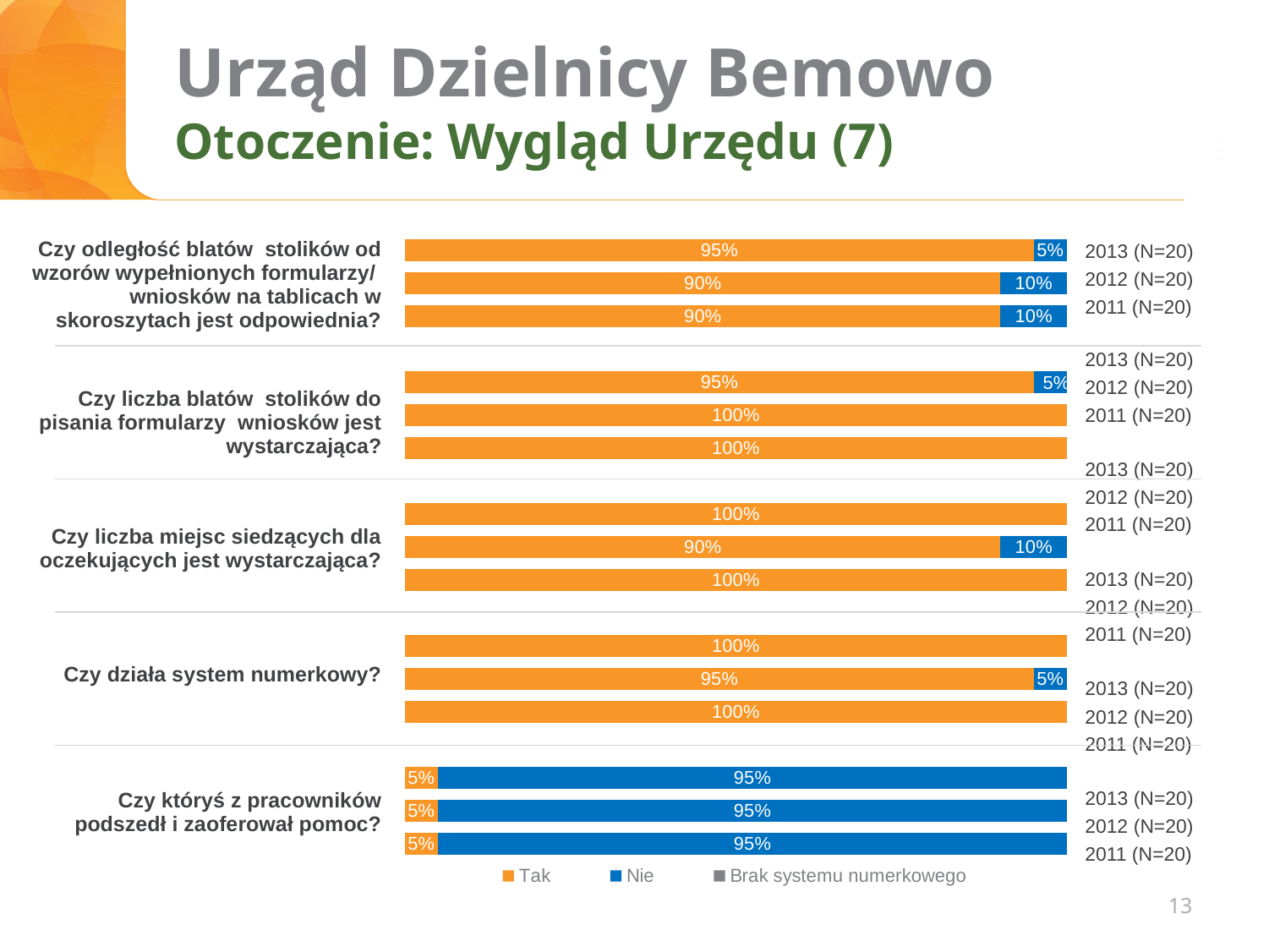
For the question 'Czy odległość blatów stolików od wzorów wypełnionych formularzy/wniosków na tablicach w skoroszytach jest odpowiednia?', which year has the highest 'Tak' value? 2013 (N=20) For the question 'Czy odległość blatów stolików od wzorów wypełnionych formularzy/wniosków na tablicach w skoroszytach jest odpowiednia?', what is the 'Nie' value for 2012 (N=20)? 10% For the question 'Czy odległość blatów stolików od wzorów wypełnionych formularzy/wniosków na tablicach w skoroszytach jest odpowiednia?', what is the 'Tak' value for 2011 (N=20)? 90% What kind of chart is shown on the slide? stacked bar chart For the question 'Czy któryś z pracowników podszedł i zaoferował pomoc?', what is the 'Tak' value shown on the bottom bar? 5% How many series does the chart legend list? 3 How many question groups are shown on the chart? 5 For the question 'Czy odległość blatów stolików od wzorów wypełnionych formularzy/wniosków na tablicach w skoroszytach jest odpowiednia?', what is the difference between the 'Tak' values for 2013 and 2012? 5% For the question 'Czy któryś z pracowników podszedł i zaoferował pomoc?', what is the 'Nie' value shown on the top bar? 95% For the question 'Czy odległość blatów stolików od wzorów wypełnionych formularzy/wniosków na tablicach w skoroszytach jest odpowiednia?', what is the 'Tak' value for 2013 (N=20)? 95% Which series does the orange colour represent in the legend? Tak For the question 'Czy działa system numerkowy?', what is the 'Nie' value on the middle bar? 5%